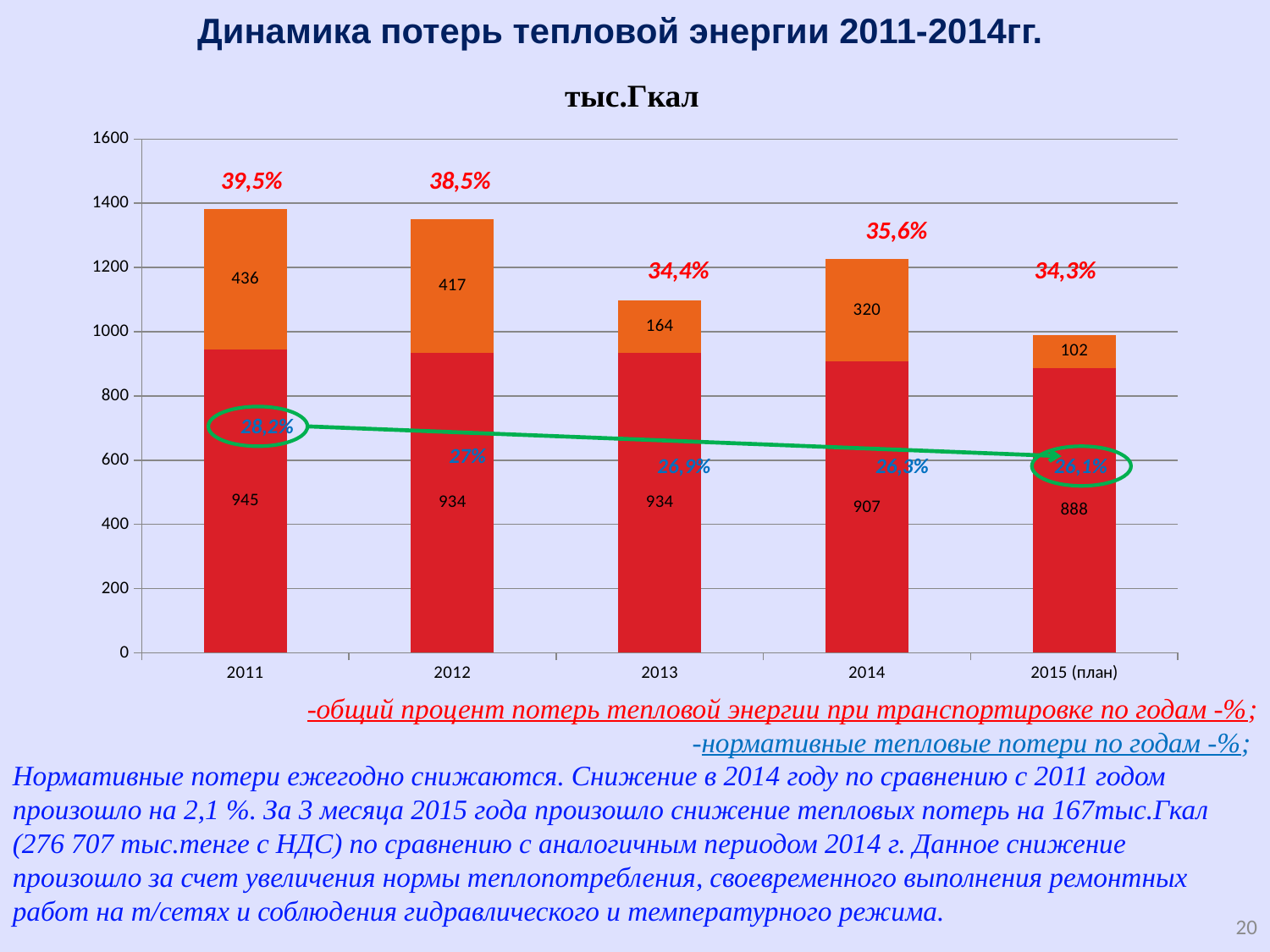
What is the value of the red (bottom) segment for 2011? 945 What kind of chart is shown on the slide? Stacked bar chart Is the orange segment larger for 2013 or for 2014? 2014 How many years (categories) are shown on the x axis? 5 Which year has the largest orange (top) segment? 2011 What is the value of the orange (top) segment for 2013? 164 What is the value of the red (bottom) segment for 2015 (план)? 888 What is the total of the stacked bar for 2012? 1351 Which year has the smallest red (bottom) segment? 2015 (план) What is the red percentage label shown above the bar for 2014? 35,6% What is the value of the orange (top) segment for 2014? 320 What is the difference between the orange segments for 2011 and 2012? 19